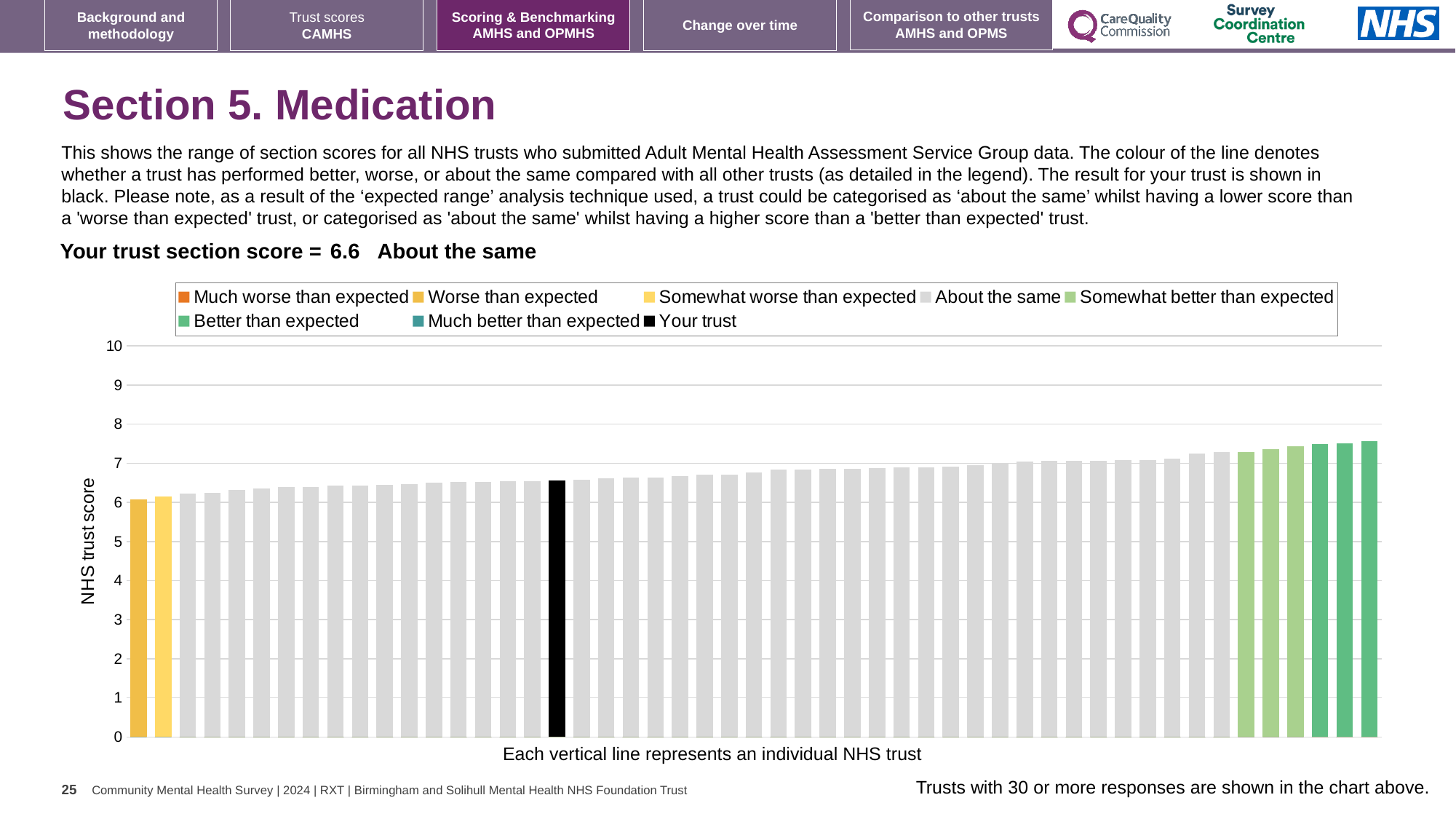
Which performance category is your trust placed in according to the slide? About the same What is the label on the vertical axis of the chart? NHS trust score Is the value for your trust greater or less than 7? less What is your trust's section score shown on the slide? 6.6 How many entries does the chart legend list? 8 Is your trust's bar taller or shorter than the rightmost bar? shorter Is the value for the rightmost bar greater or less than 8? less Is the value for your trust greater or less than 5? greater What colour is the bar representing your trust? black Do the bar values rise or fall from left to right along the x axis? rise What kind of chart is shown on the slide? bar chart